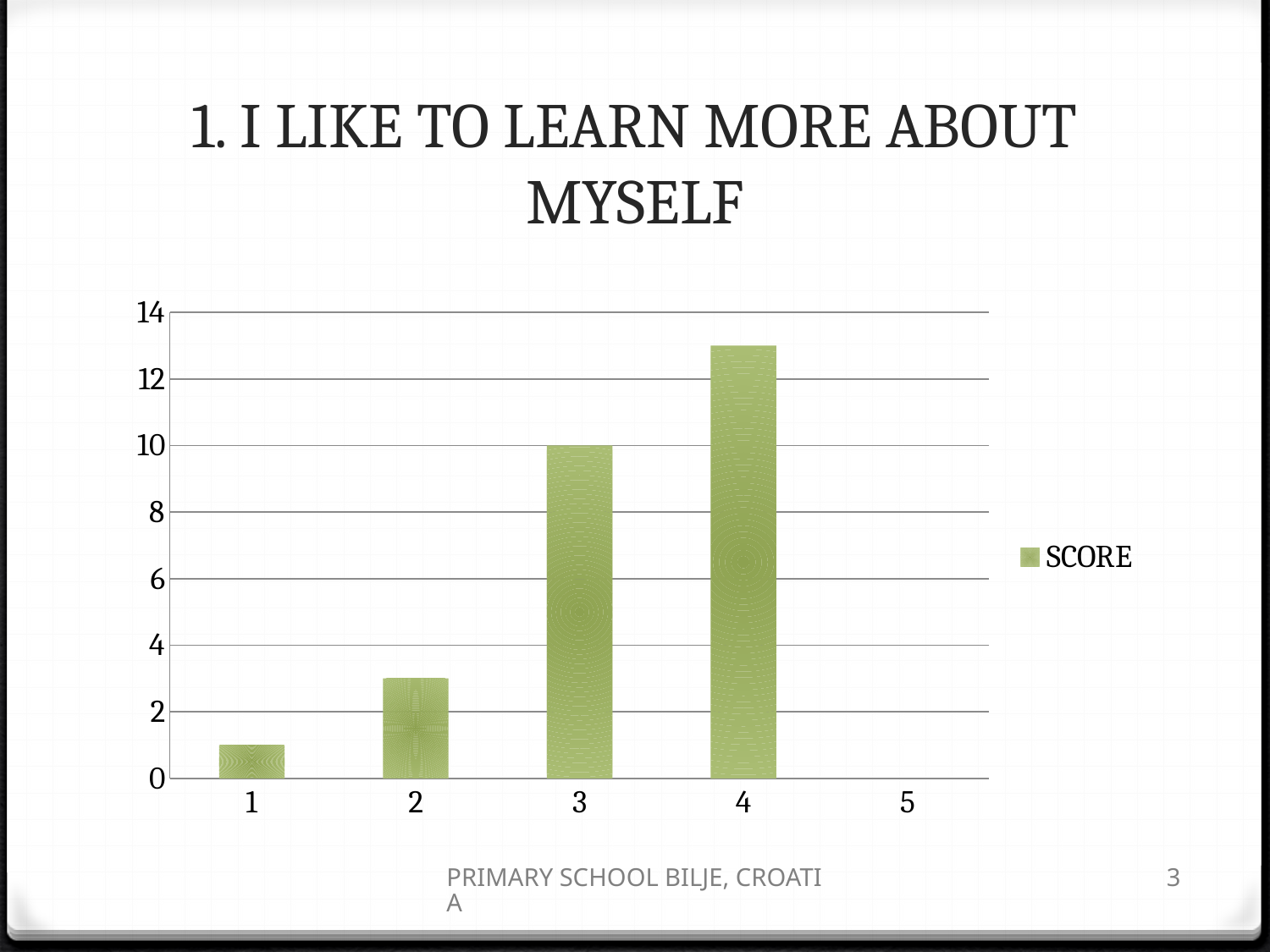
What is the value for category 3? 10 Is the value for category 1 greater or less than 2? less Which has a larger value, category 3 or category 4? 4 Which category has the highest value? 4 What kind of chart is shown on the slide? bar chart Do the values rise or fall from category 1 to category 4? rise Is the value for category 4 greater or less than 12? greater Is the value for category 2 greater or less than 4? less How many categories are shown on the x axis? 5 How many series does the legend list? 1 Which category has the shortest visible bar? 1 What is the name of the series shown in the legend? SCORE